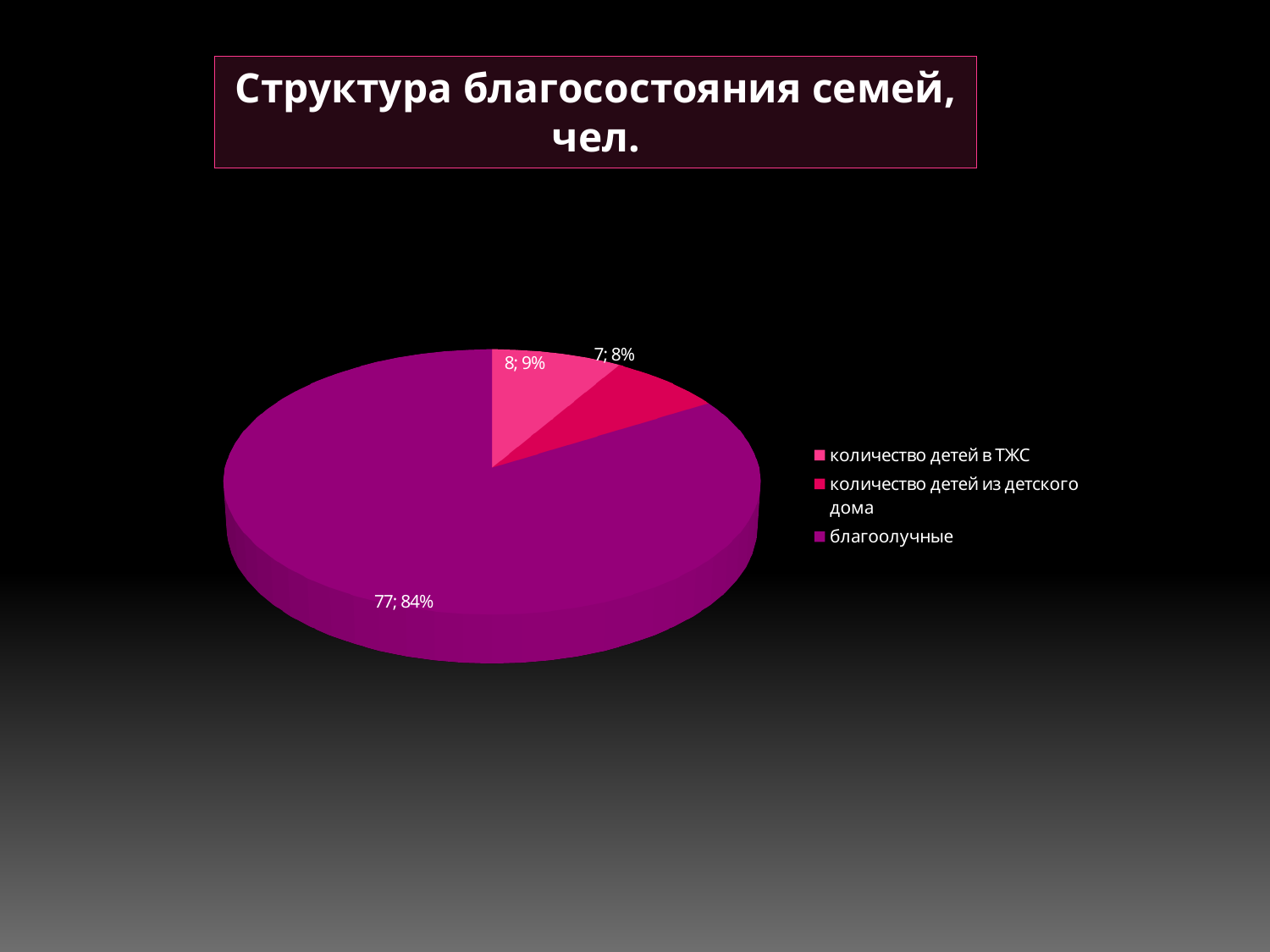
How many slices does the pie chart have? 3 What is the value for "количество детей в ТЖС"? 8 How many entries does the legend list? 3 What share of the pie does "благоолучные" take? 84% What share of the pie does "количество детей в ТЖС" take? 9% What is the value for "благоолучные"? 77 What is the value for "количество детей из детского дома"? 7 What kind of chart is shown on the slide? pie chart Which category has the largest slice? благоолучные Which category has the smallest slice? количество детей из детского дома What is the difference between the values for "благоолучные" and "количество детей в ТЖС"? 69 What is the title of the chart? Структура благосостояния семей, чел.